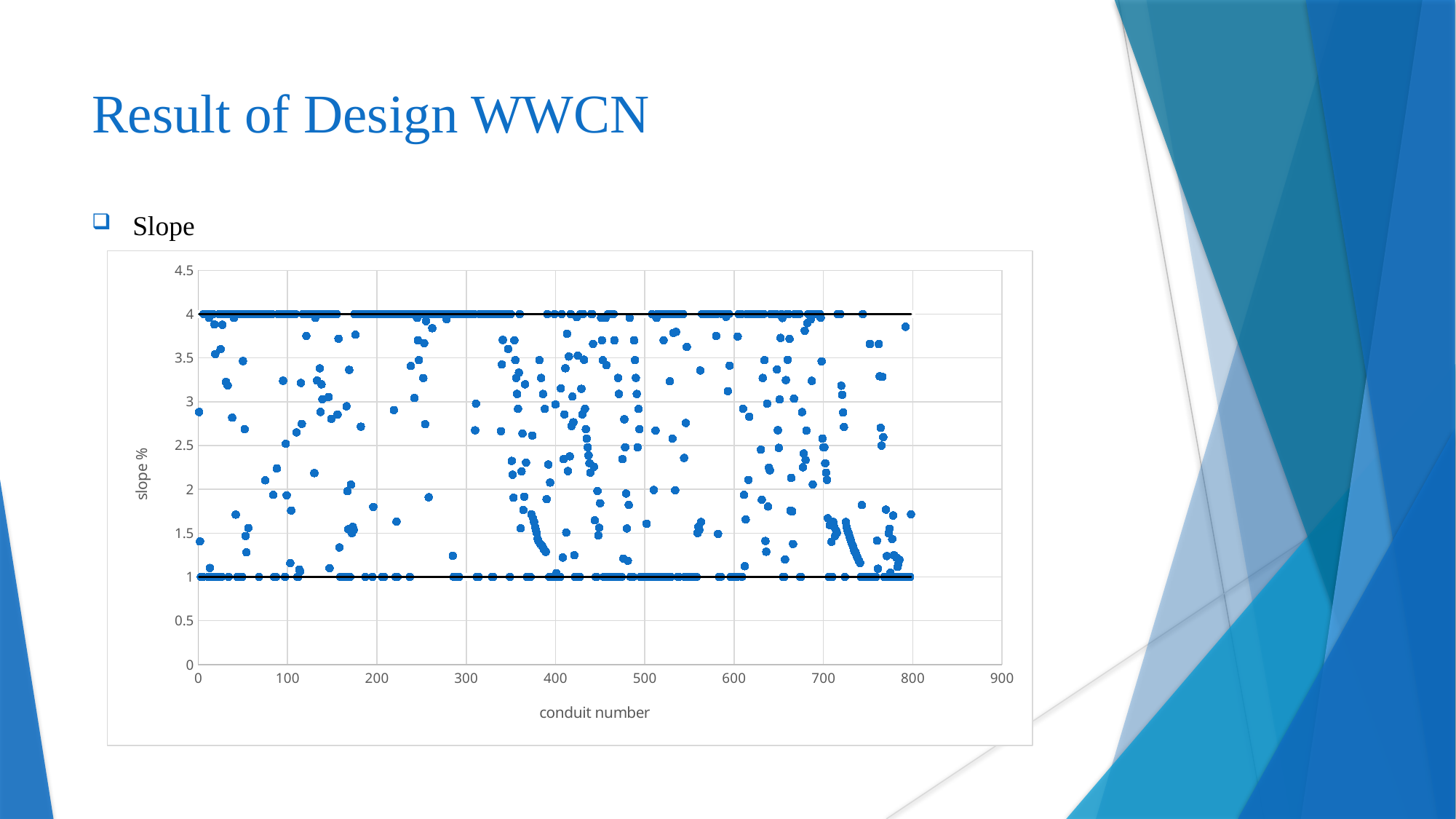
How many horizontal black reference lines are drawn on the chart? 2 Is the highest plotted slope % value greater or less than 4.5? less What is the title of the x axis of the chart? conduit number At what slope % value is the lower horizontal black line drawn? 1 What is the title of the y axis of the chart? slope % Is the lowest plotted slope % value greater or less than 0.5? greater Is the largest conduit number plotted greater or less than 900? less What kind of chart is shown on the slide? scatter chart At what slope % value is the upper horizontal black line drawn? 4